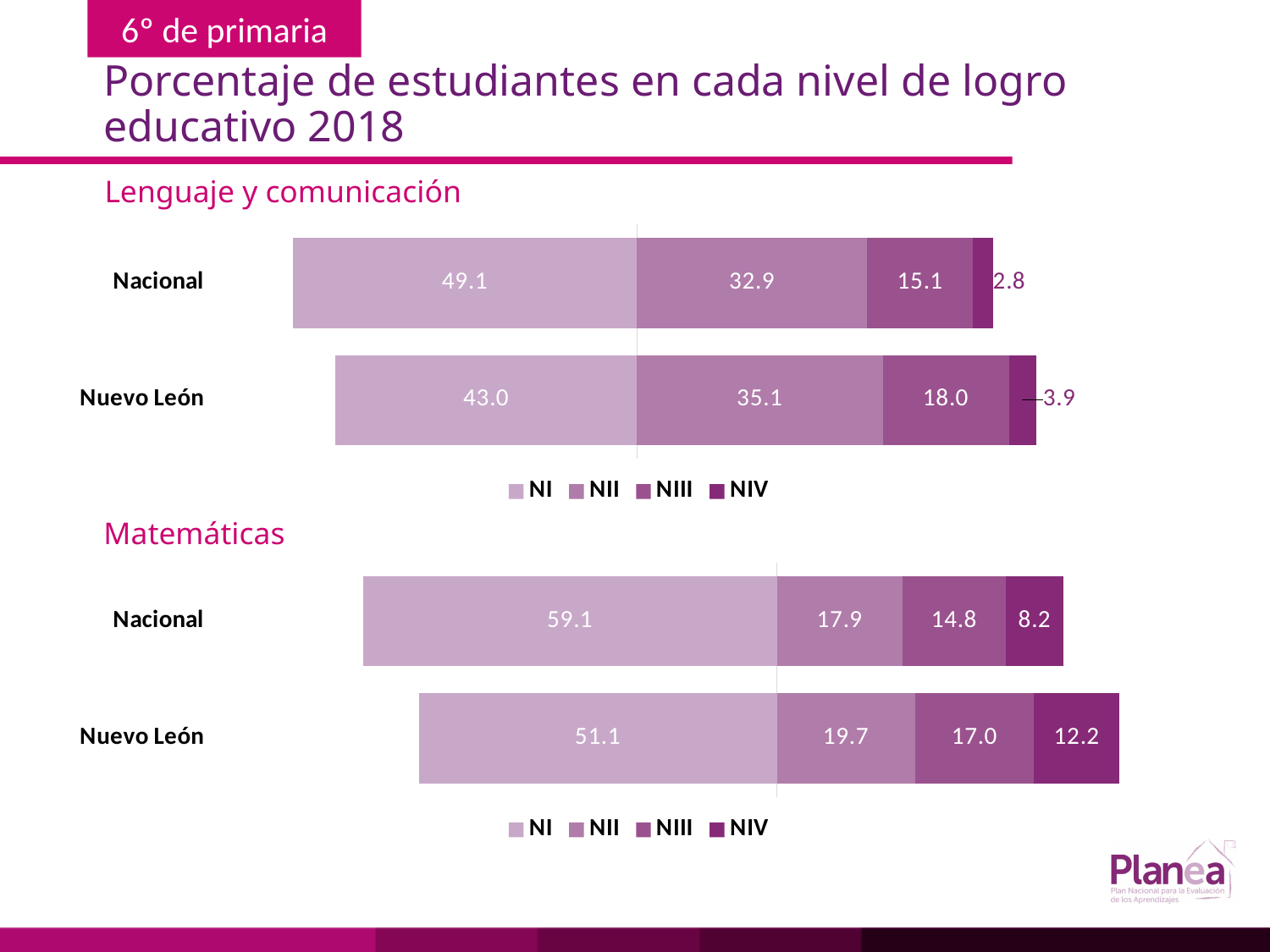
In the Lenguaje y comunicación chart, which level has the lowest value for Nacional? NIV How many series does the legend of the Matemáticas chart list? 4 In the Lenguaje y comunicación chart, what is the NI value for Nacional? 49.1 In the Matemáticas chart, what is the NII value for Nuevo León? 19.7 In the Lenguaje y comunicación chart, what is the difference between the NI values for Nacional and Nuevo León? 6.1 In the Lenguaje y comunicación chart, what is the total of the stacked bar for Nuevo León? 100.0 In the Lenguaje y comunicación chart, what is the NIV value for Nuevo León? 3.9 In the Matemáticas chart, which is larger, the NI value for Nacional or for Nuevo León? Nacional In the Matemáticas chart, what is the difference between the NIV values for Nuevo León and Nacional? 4.0 In the Matemáticas chart, which level has the highest value for Nuevo León? NI In the Matemáticas chart, what is the NIII value for Nacional? 14.8 What kind of chart is the Lenguaje y comunicación chart? Stacked bar chart